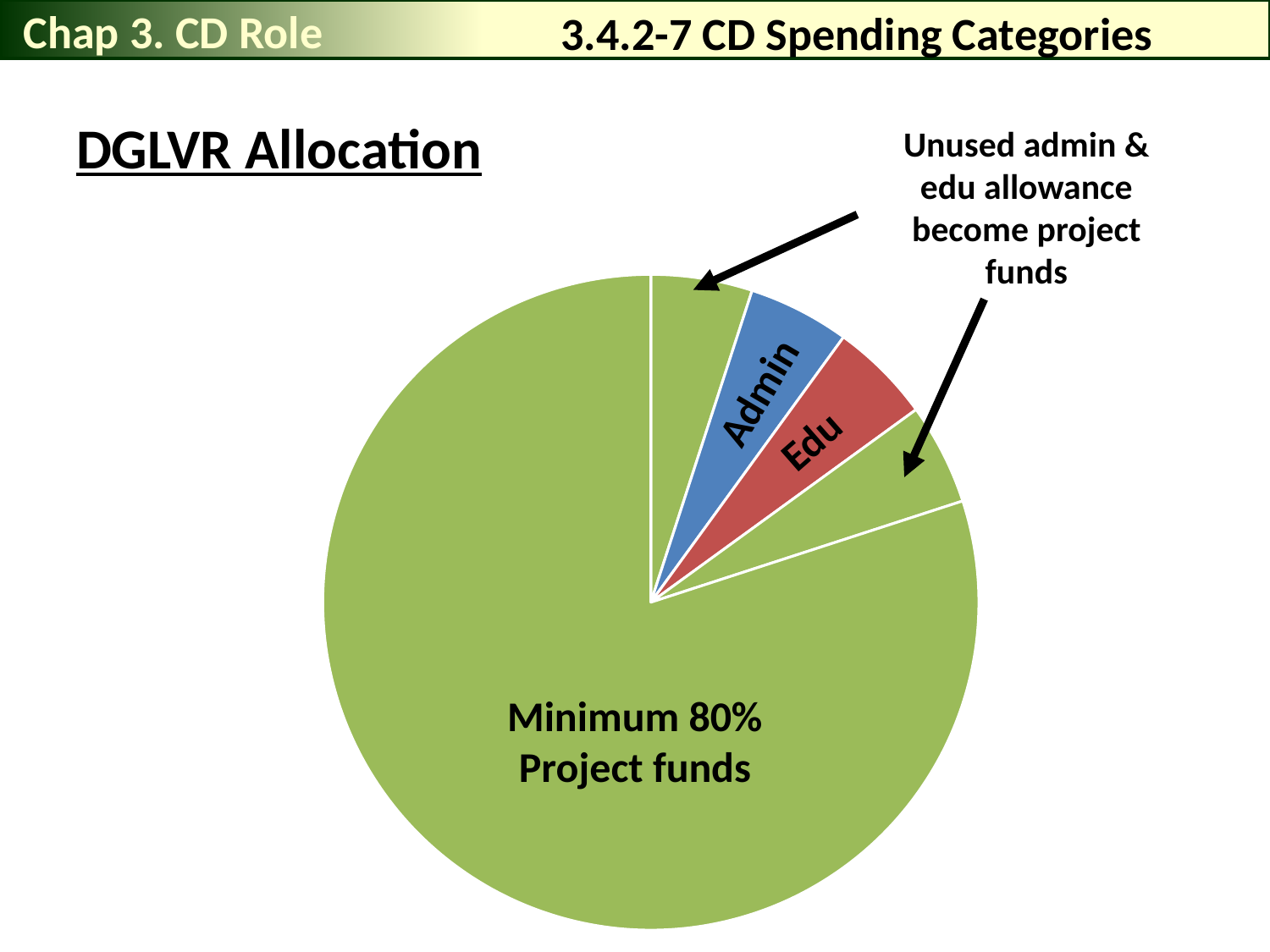
Which is larger, the Edu slice or the Project funds slice? Project funds What is the title of the pie chart? DGLVR Allocation What kind of chart is shown on the slide? pie chart What colour is the Admin slice? blue What minimum percentage is printed on the Project funds slice? 80% According to the annotation, what do unused admin and edu allowances become? project funds Which is larger, the Project funds slice or the Admin slice? Project funds Which slice of the pie chart is the largest? Minimum 80% Project funds How many slices does the pie chart have? 5